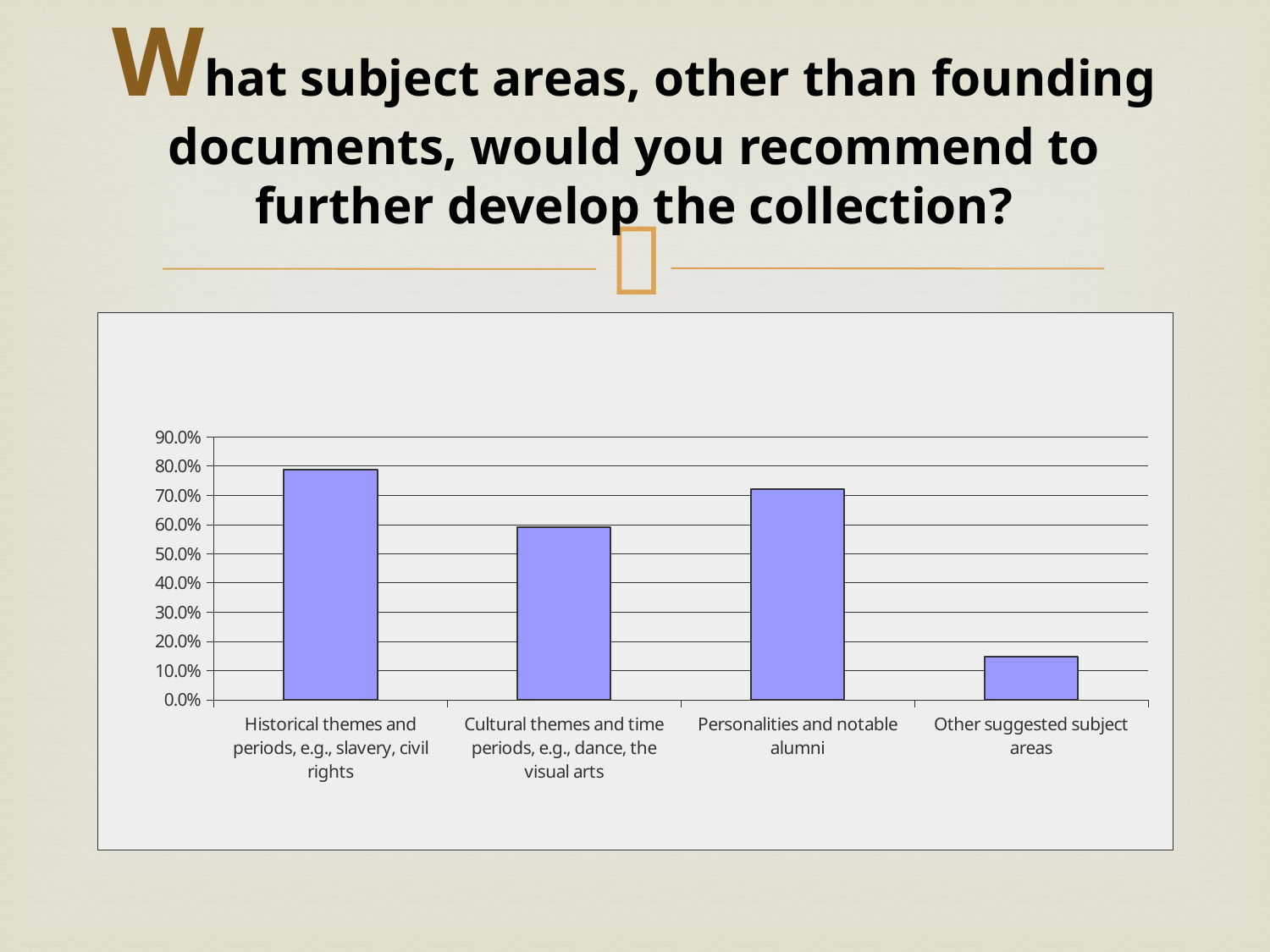
Which category has the highest value? Historical themes and periods, e.g., slavery, civil rights What is the highest value shown on the vertical axis? 90.0% Is the value for Other suggested subject areas greater or less than 20.0%? less Is the value for Personalities and notable alumni greater or less than 80.0%? less Which is larger: the value for Cultural themes and time periods, e.g., dance, the visual arts or the value for Personalities and notable alumni? Personalities and notable alumni What kind of chart is shown on the slide? bar chart Is the value for Historical themes and periods, e.g., slavery, civil rights greater or less than 70.0%? greater Which is larger: the value for Historical themes and periods, e.g., slavery, civil rights or the value for Personalities and notable alumni? Historical themes and periods, e.g., slavery, civil rights Which category has the lowest value? Other suggested subject areas How many categories are shown on the chart? 4